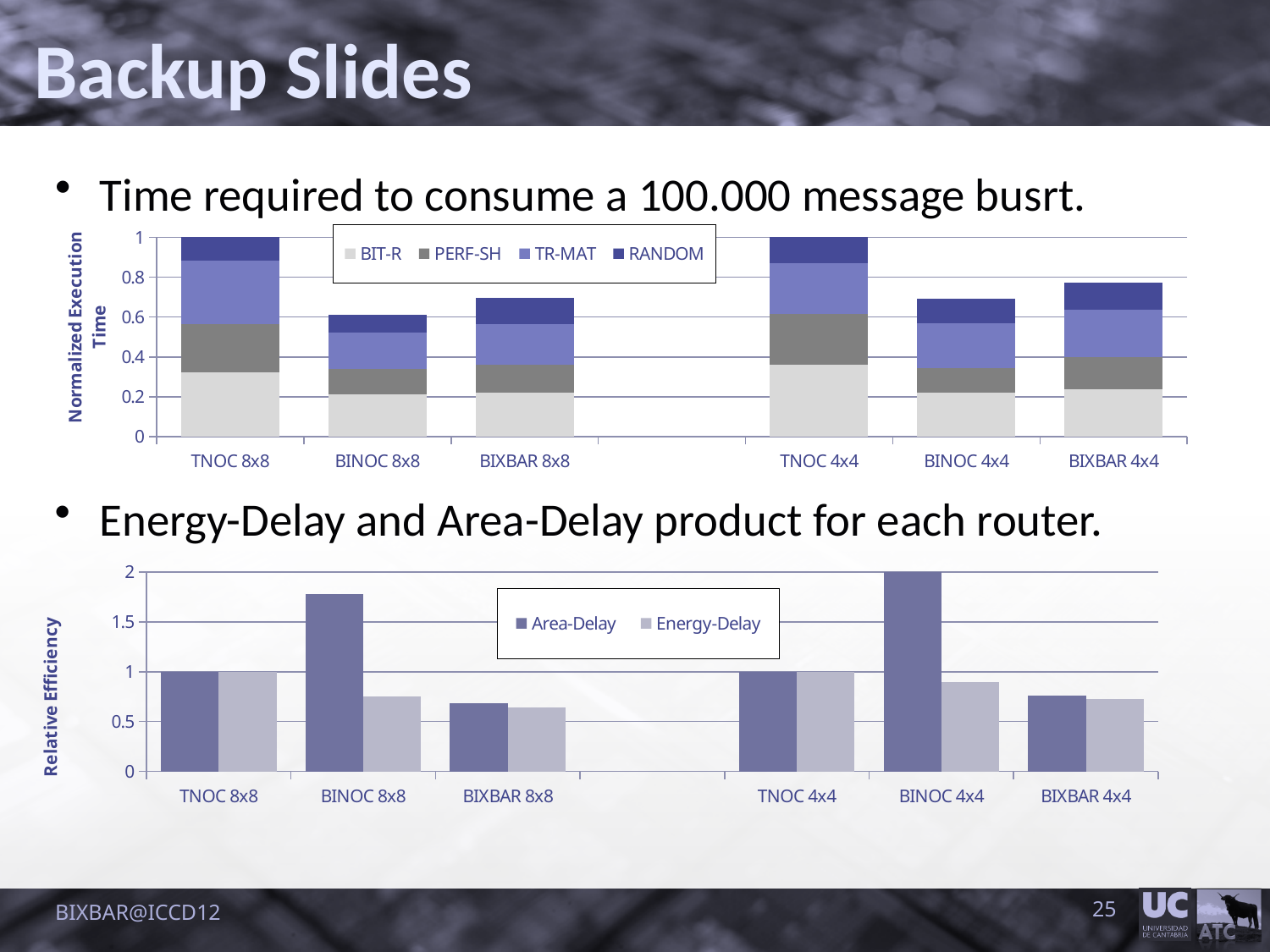
Which series are listed in the legend of the top chart (Normalized Execution Time)? BIT-R, PERF-SH, TR-MAT, RANDOM In the bottom chart (Relative Efficiency), which category has the highest Area-Delay value? BINOC 4x4 How many series does the legend of the top chart (Normalized Execution Time) list? 4 What kind of chart is the bottom chart (Relative Efficiency)? Bar chart How many series does the legend of the bottom chart (Relative Efficiency) list? 2 In the top chart (Normalized Execution Time), which has the larger total stacked value, TNOC 8x8 or BINOC 8x8? TNOC 8x8 In the top chart (Normalized Execution Time), what is the total stacked value for TNOC 8x8? 1 In the bottom chart (Relative Efficiency), is the Energy-Delay value for BINOC 8x8 greater or less than 1? less How many router categories are shown on the x axis of the top chart (Normalized Execution Time)? 6 What kind of chart is the top chart (Normalized Execution Time)? Stacked bar chart In the top chart (Normalized Execution Time), is the total stacked value for BINOC 8x8 greater or less than 0.8? less